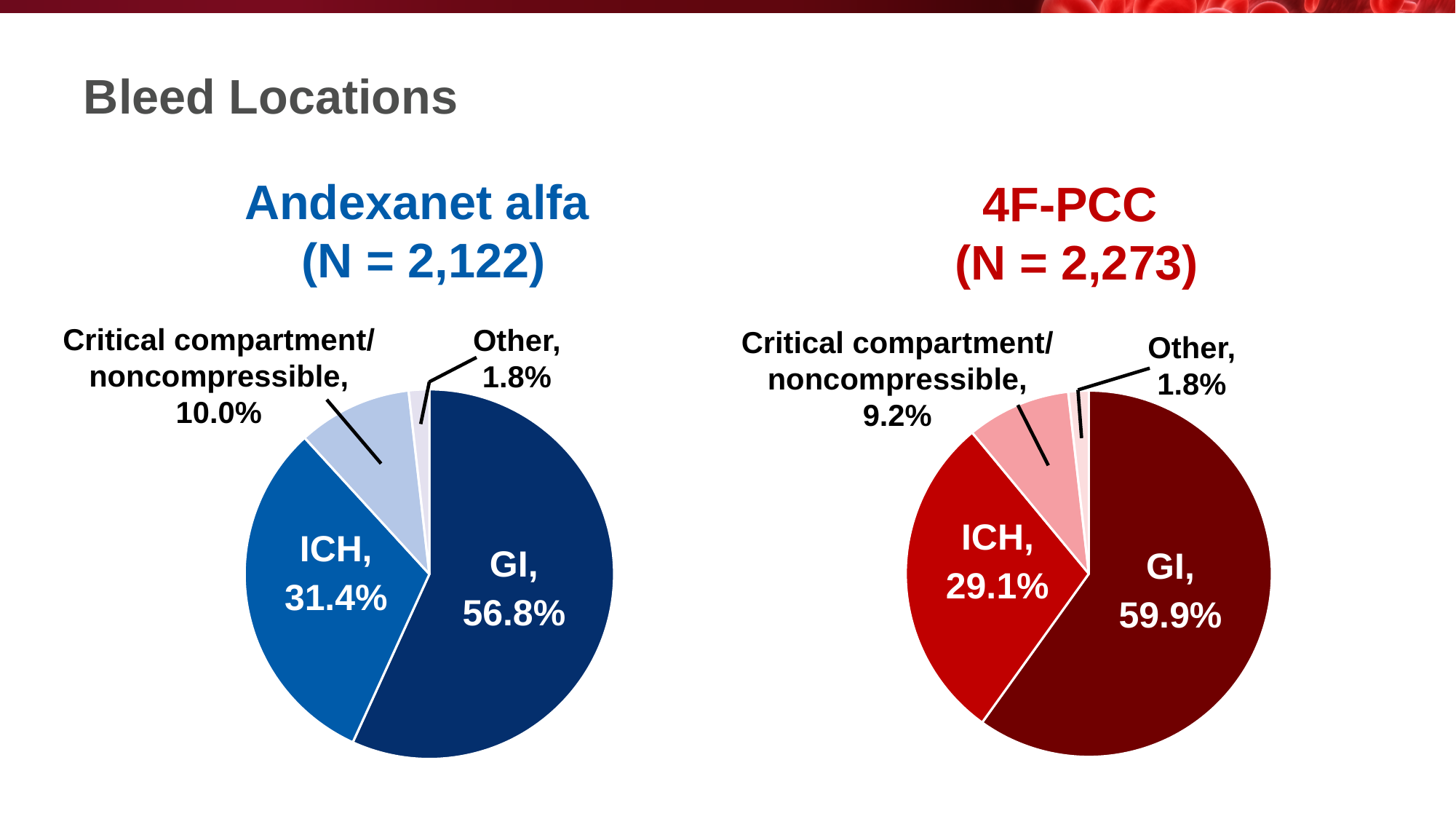
In the 4F-PCC pie chart, which bleed location has the largest share? GI In the Andexanet alfa pie chart, what is the value for Critical compartment/noncompressible? 10.0% In the 4F-PCC pie chart, what share of bleeds are ICH? 29.1% Which is larger: the ICH share in the Andexanet alfa chart or the ICH share in the 4F-PCC chart? Andexanet alfa In the Andexanet alfa pie chart, what share of bleeds are GI? 56.8% What is the title of the slide? Bleed Locations How many slices does the 4F-PCC pie chart have? 4 In the 4F-PCC pie chart, what is the value for Other? 1.8% In the Andexanet alfa pie chart, what is the difference between the GI and ICH shares? 25.4% What is the sample size (N) shown for the 4F-PCC chart? 2,273 What type of chart is used for the Andexanet alfa data? Pie chart In the Andexanet alfa pie chart, which bleed location has the smallest share? Other